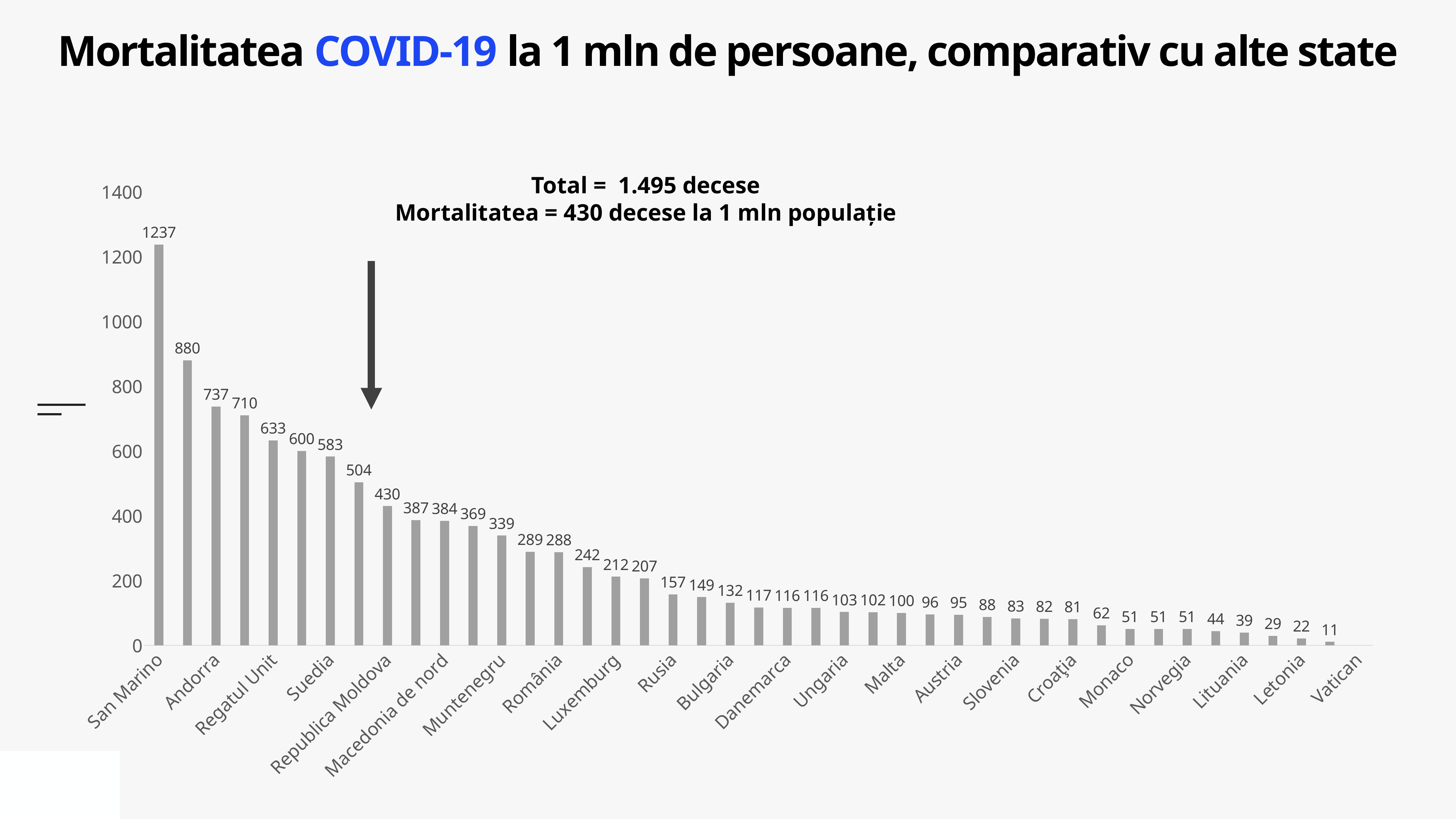
What is the value shown for Republica Moldova? 430 Do the values rise or fall from left to right along the x axis? fall Which country has the highest COVID-19 mortality per 1 mln people in the chart? San Marino What is the value shown for Rusia? 157 What is the value shown for Muntenegru? 339 According to the text on the slide, what is the total number of deaths (Total)? 1.495 decese What is the difference between the values for San Marino and Republica Moldova? 807 What is the value shown for San Marino? 1237 Which has a higher value, Regatul Unit or Suedia? Regatul Unit What type of chart is shown on the slide? bar chart